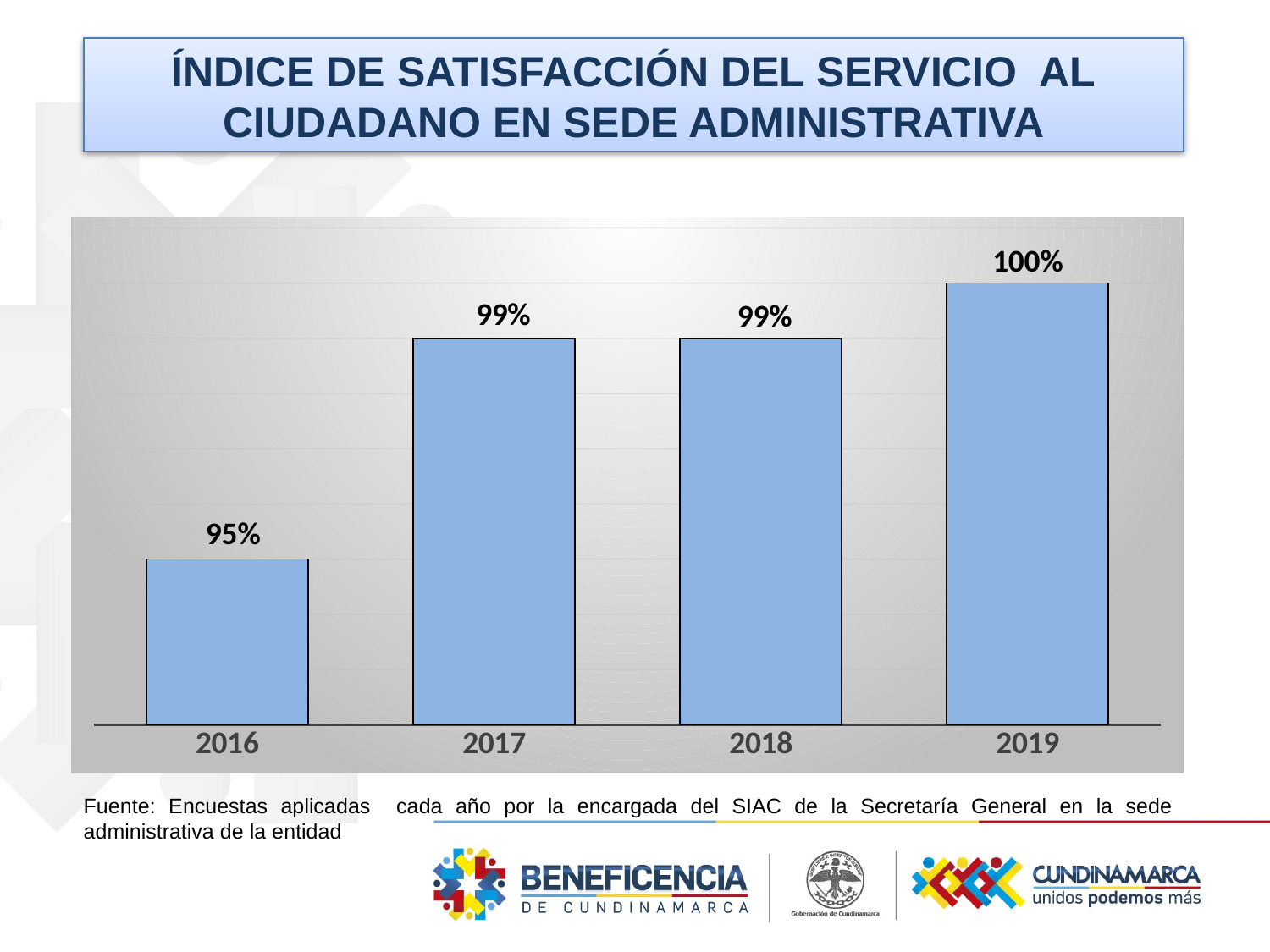
What is the difference between the 2017 value and the 2016 value? 4% How many years are shown on the x axis of the chart? 4 What is the difference between the 2019 value and the 2016 value? 5% Which year has the lowest satisfaction index? 2016 What is the satisfaction index value for 2017? 99% What is the title of the chart on the slide? ÍNDICE DE SATISFACCIÓN DEL SERVICIO AL CIUDADANO EN SEDE ADMINISTRATIVA What is the satisfaction index value for 2016? 95% Which year has the highest satisfaction index? 2019 What is the satisfaction index value for 2019? 100% Which is larger, the value for 2016 or the value for 2018? 2018 Do the values generally rise or fall from 2016 to 2019? Rise What kind of chart is shown on the slide? Bar chart